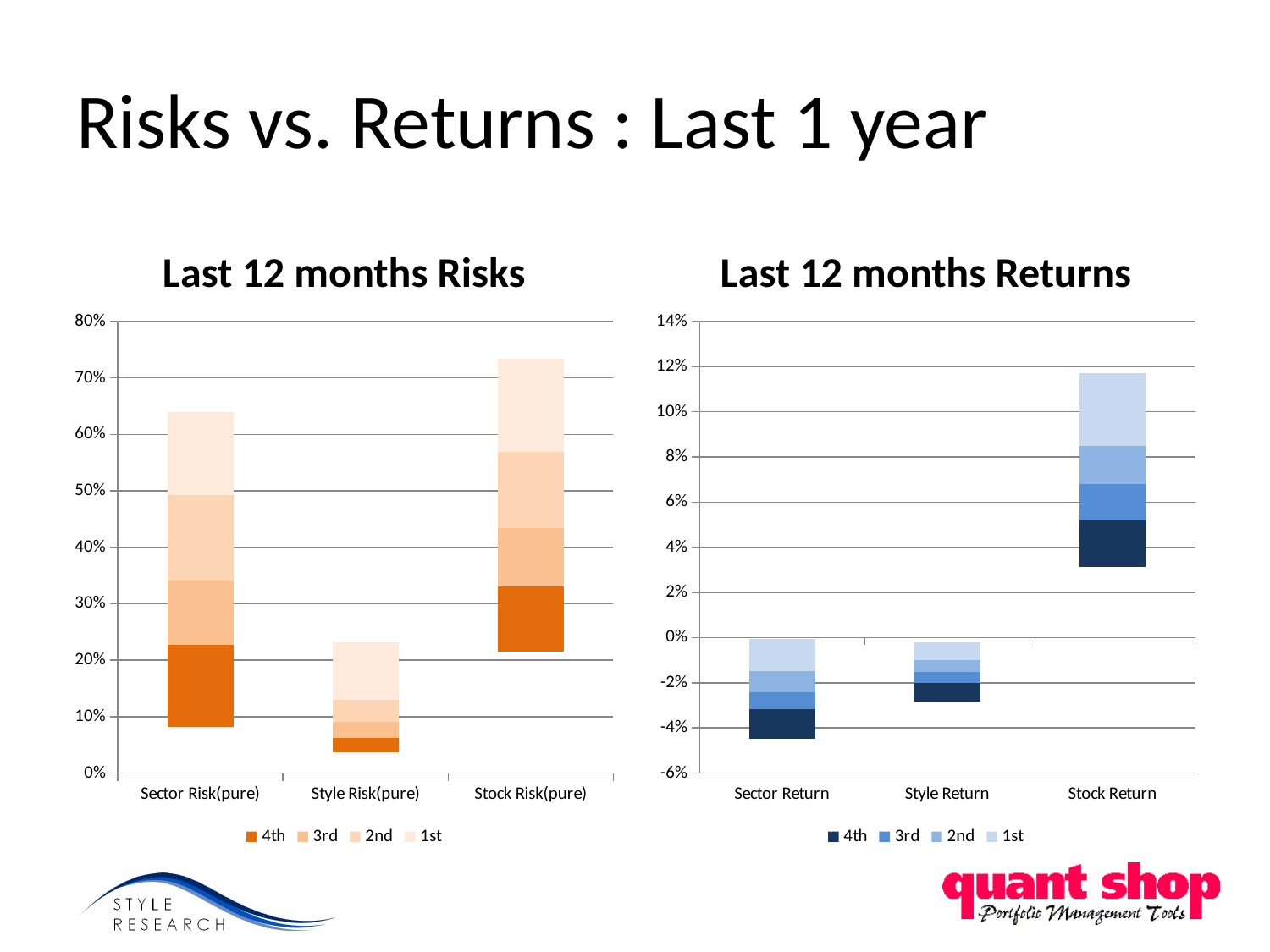
In the 'Last 12 months Risks' chart, is the top of the stacked bar for Style Risk(pure) greater or less than 30%? less In the 'Last 12 months Returns' chart, how many series does the legend list? 4 In the 'Last 12 months Risks' chart, which category has the highest top of its stacked bar? Stock Risk(pure) What are the legend entries of the 'Last 12 months Risks' chart? 4th, 3rd, 2nd, 1st In the 'Last 12 months Returns' chart, which reaches a lower value: the bottom of the Sector Return bar or the bottom of the Style Return bar? Sector Return In the 'Last 12 months Risks' chart, how many categories are shown on the x axis? 3 What kind of chart is the 'Last 12 months Risks' chart? bar chart In the 'Last 12 months Risks' chart, which category has the lowest top of its stacked bar? Style Risk(pure) In the 'Last 12 months Returns' chart, which category has the highest top of its stacked bar? Stock Return In the 'Last 12 months Returns' chart, is the bottom of the stacked bar for Sector Return greater or less than -3%? less In the 'Last 12 months Risks' chart, is the top of the stacked bar for Stock Risk(pure) greater or less than 70%? greater